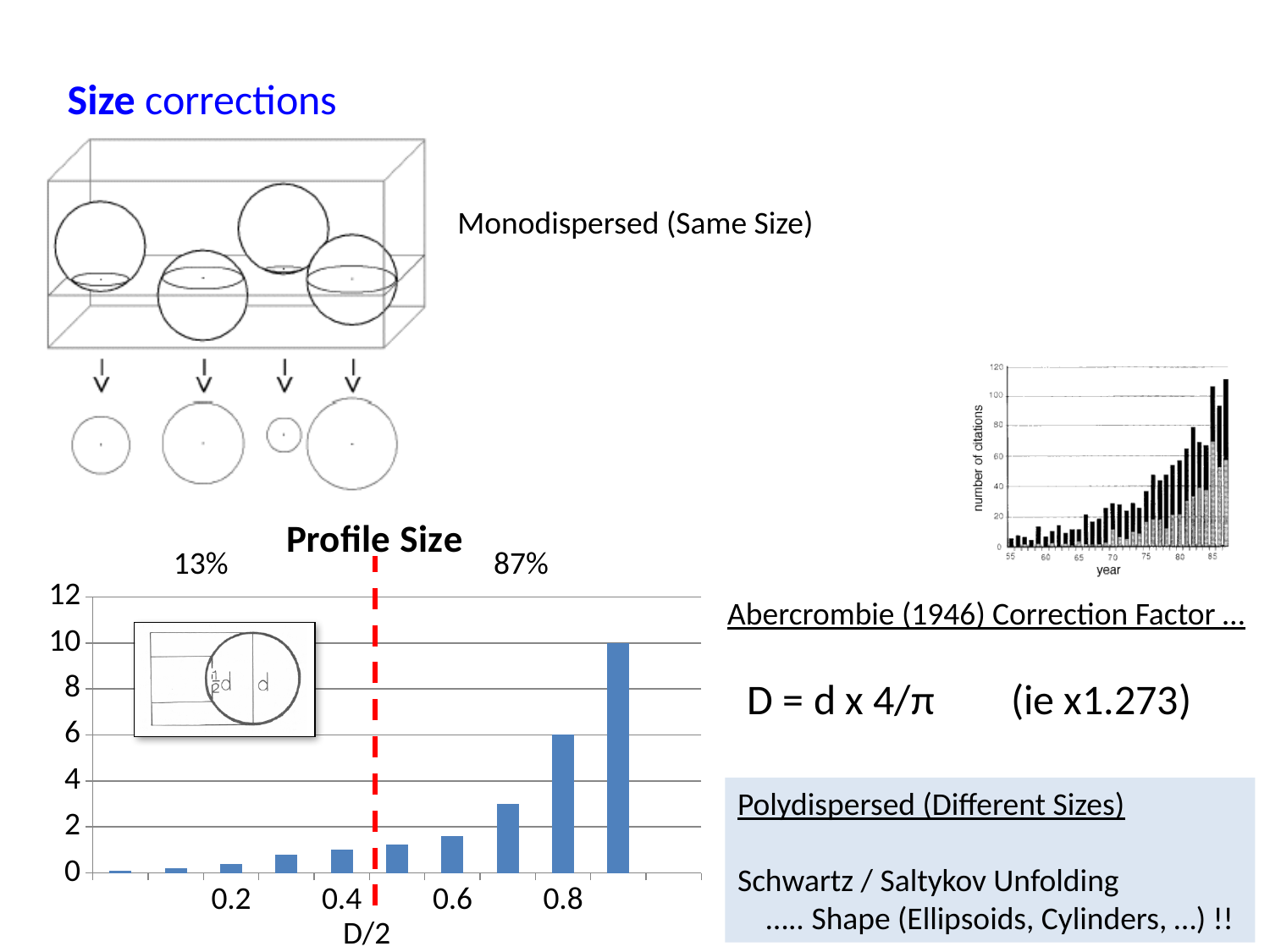
In the 'Profile Size' chart, which bar is the tallest: the rightmost bar or the second bar from the right? the rightmost bar What is the highest value shown on the y-axis of the 'Profile Size' chart? 12 In the 'Profile Size' chart, do the bar values rise or fall as D/2 increases? rise What is the title of the bar chart at the bottom left of the slide? Profile Size How many bars are plotted in the 'Profile Size' chart? 10 In the 'number of citations' chart on the right, do the values generally rise or fall as the year increases? rise In the 'Profile Size' chart, is the value of the bar above the 0.8 tick greater or less than 4? greater What kind of chart is the 'Profile Size' chart? bar chart In the 'Profile Size' chart, is the value of the bar above the 0.2 tick greater or less than 2? less What is the x-axis label of the 'Profile Size' chart? D/2 What kind of chart is the small 'number of citations' versus 'year' chart on the right of the slide? bar chart In the 'Profile Size' chart, is the value of the rightmost bar greater or less than 8? greater